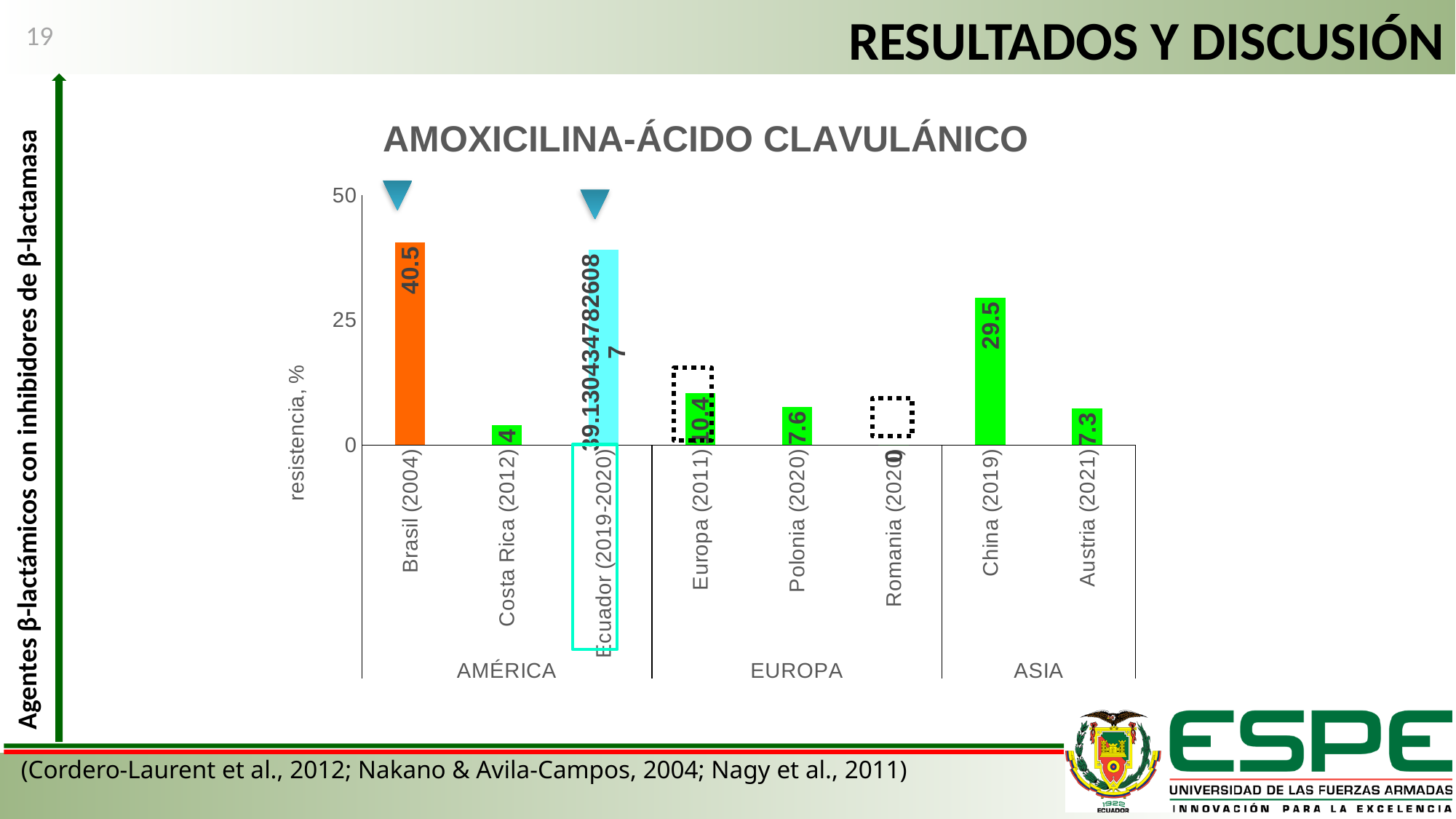
How many countries/regions are shown as bars in the chart? 8 What type of chart is shown on the slide? bar chart What is the resistance value for Brasil (2004)? 40.5 What is the difference between the resistance values for Brasil (2004) and China (2019)? 11 What is the resistance value for Polonia (2020)? 7.6 Which has a higher resistance value, Polonia (2020) or Costa Rica (2012)? Polonia (2020) What is the difference between the resistance values for China (2019) and Europa (2011)? 19.1 Is the resistance value for Ecuador (2019-2020) greater or less than 25? greater What is the resistance value for China (2019)? 29.5 What is the resistance value for Costa Rica (2012)? 4 What is the title of the chart? AMOXICILINA-ÁCIDO CLAVULÁNICO Which country has the lowest resistance value in the chart? Romania (2020)